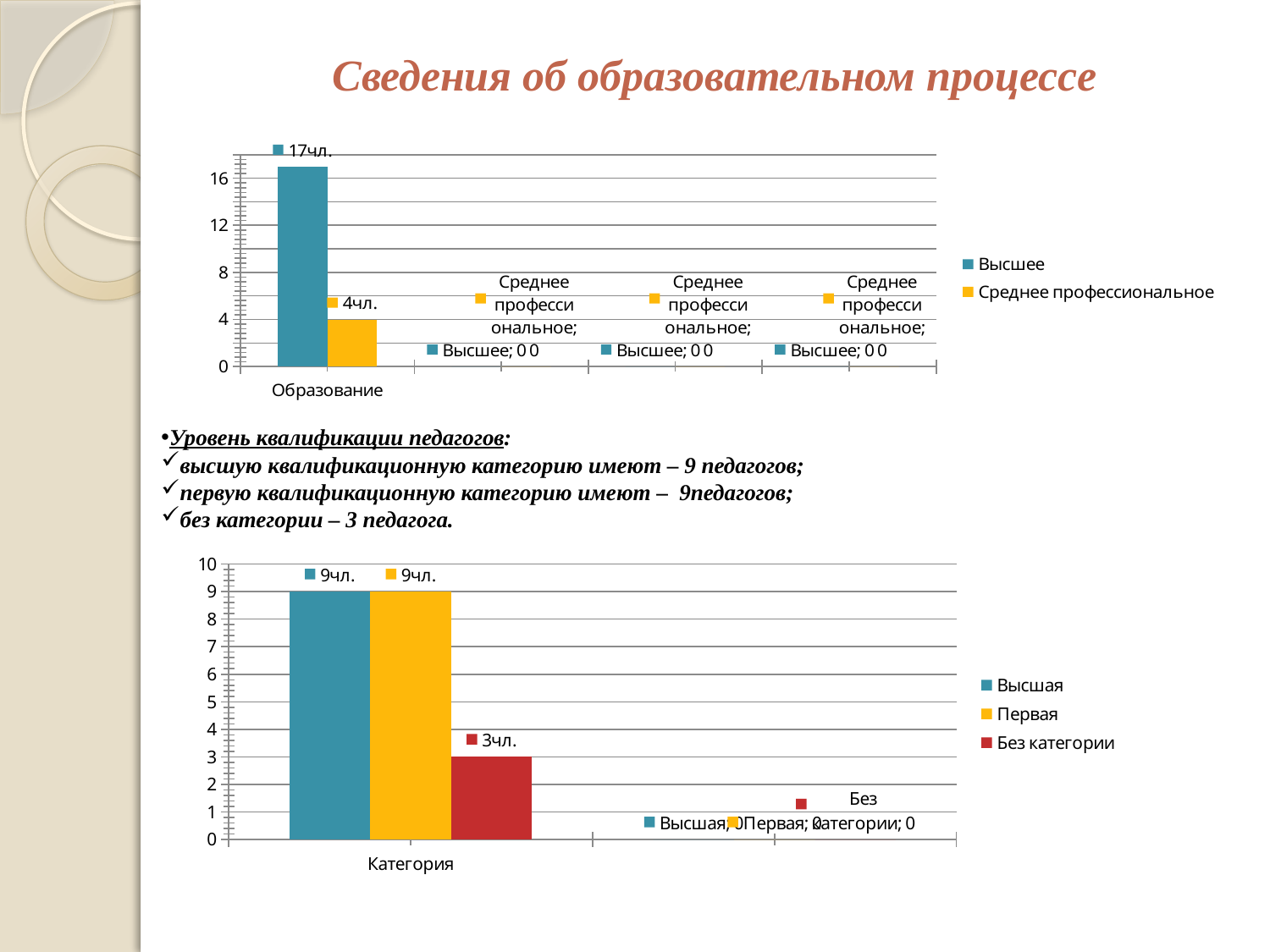
In the bottom chart, what is the difference between the Первая and Без категории values? 6 In the top chart, what is the difference between the Высшее and Среднее профессиональное values for Образование? 13 How many series does the legend of the top chart list? 2 In the top chart, what is the value for Высшее in the Образование category? 17чл. What kind of chart is the top chart? bar chart In the top chart, what is the value for Среднее профессиональное in the Образование category? 4чл. How many series does the legend of the bottom chart list? 3 In the top chart, which series has the higher value for Образование, Высшее or Среднее профессиональное? Высшее In the bottom chart, what is the value for Высшая in the Категория group? 9чл. In the bottom chart, which series has the lowest value? Без категории In the bottom chart, what colour is the bar for Без категории? red In the bottom chart, what is the value for Без категории? 3чл.